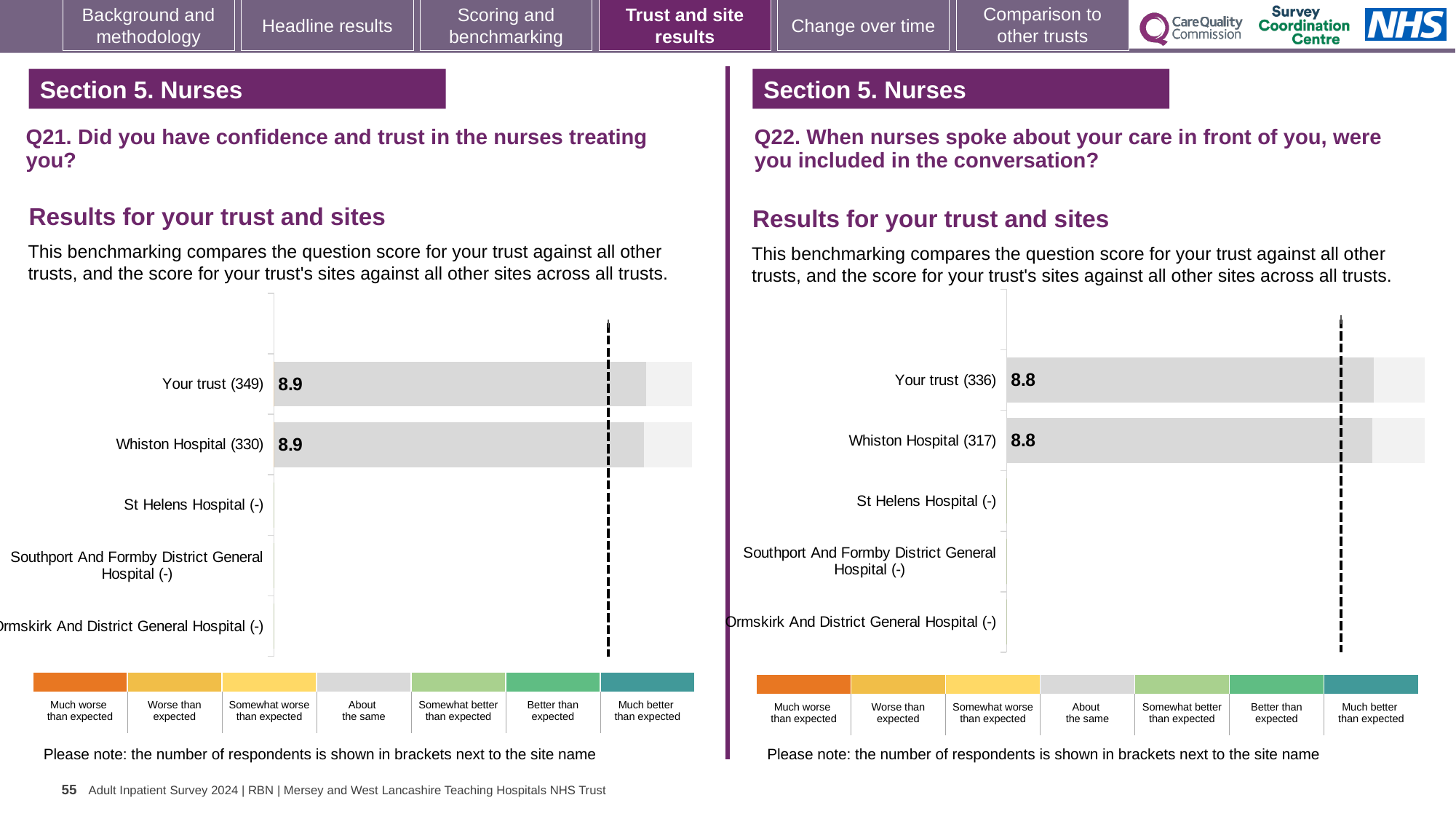
How many site/trust categories are listed on the Q22 chart (right)? 5 On the Q22 chart (right), how many respondents are shown in brackets for Your trust? 336 On the Q22 chart (right), what is the score for Whiston Hospital (317)? 8.8 On the Q21 chart (left), what is the score for Your trust (349)? 8.9 On the Q21 chart (left), how many respondents are shown in brackets for Whiston Hospital? 330 On the Q21 chart (left), what is the score for Whiston Hospital (330)? 8.9 On the Q21 chart (left), what is the difference between the score for Your trust and the score for Whiston Hospital? 0.0 On the Q22 chart (right), what is the score for Your trust (336)? 8.8 What kind of chart is used on the Q21 chart (left)? Bar chart How many site/trust categories are listed on the Q21 chart (left)? 5 On the Q22 chart (right), what is the difference between the score for Your trust and the score for Whiston Hospital? 0.0